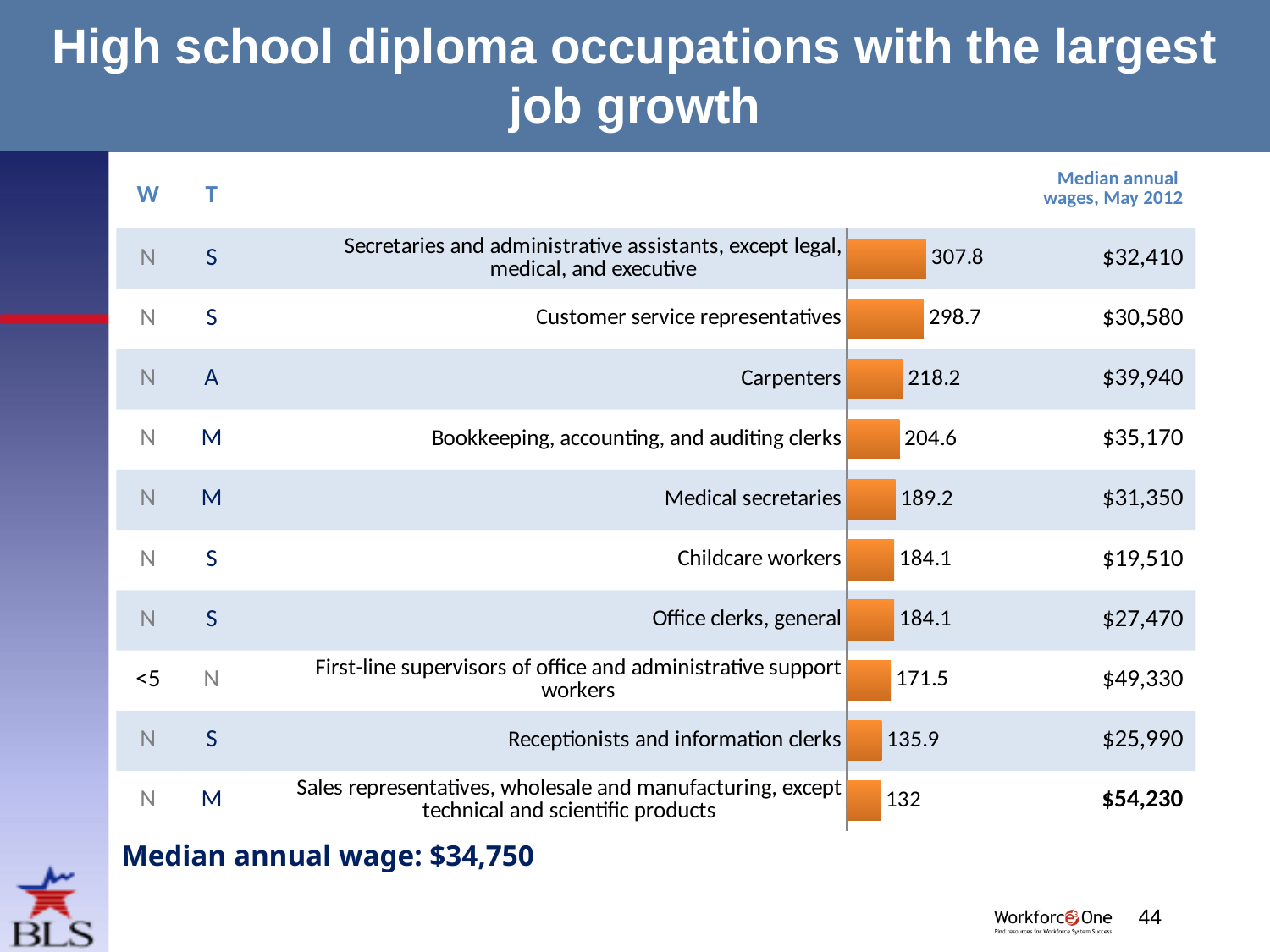
What kind of chart is used to show the job growth values? Bar chart Which occupation has the longest bar in the chart? Secretaries and administrative assistants, except legal, medical, and executive Which occupation has the shortest bar in the chart? Sales representatives, wholesale and manufacturing, except technical and scientific products Which has a larger bar value, Medical secretaries or First-line supervisors of office and administrative support workers? Medical secretaries What is the difference between the bar values for Carpenters and Bookkeeping, accounting, and auditing clerks? 13.6 What is the value of the bar for Customer service representatives? 298.7 What colour are the bars in the chart? Orange What is the difference between the bar values for Secretaries and administrative assistants, except legal, medical, and executive and Customer service representatives? 9.1 How many occupations are shown as bars in the chart? 10 What is the value of the bar for Receptionists and information clerks? 135.9 What is the value of the bar for Carpenters? 218.2 Do the bar values rise or fall going down the list of occupations? Fall